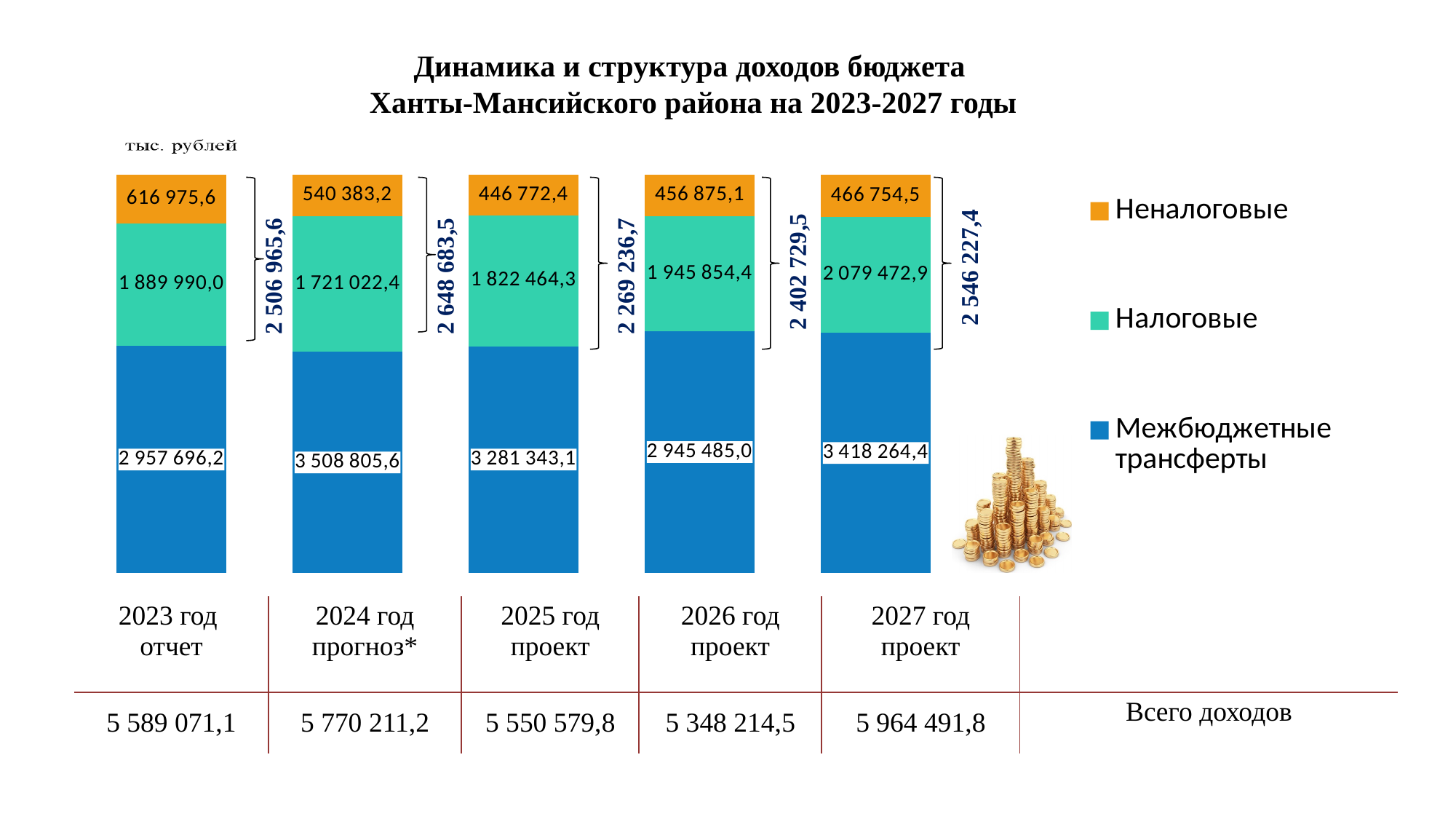
What is the difference between the Налоговые value for 2027 год проект and for 2023 год отчет? 189 482,9 How many series does the legend list? 3 What is the total income (Всего доходов) for 2026 год проект? 5 348 214,5 Which year has the lowest value for Неналоговые? 2025 год проект Which is larger: Межбюджетные трансферты for 2025 год проект or for 2026 год проект? 2025 год проект Which year has the highest value for Межбюджетные трансферты? 2024 год прогноз* What kind of chart is shown on the slide? Stacked bar chart Do the Неналоговые values rise or fall from 2023 год отчет to 2025 год проект? Fall What is the value of Налоговые for 2027 год проект? 2 079 472,9 How many years (categories) are shown on the chart? 5 What is the value of Неналоговые for 2023 год отчет? 616 975,6 What is the value of Межбюджетные трансферты for 2024 год прогноз*? 3 508 805,6